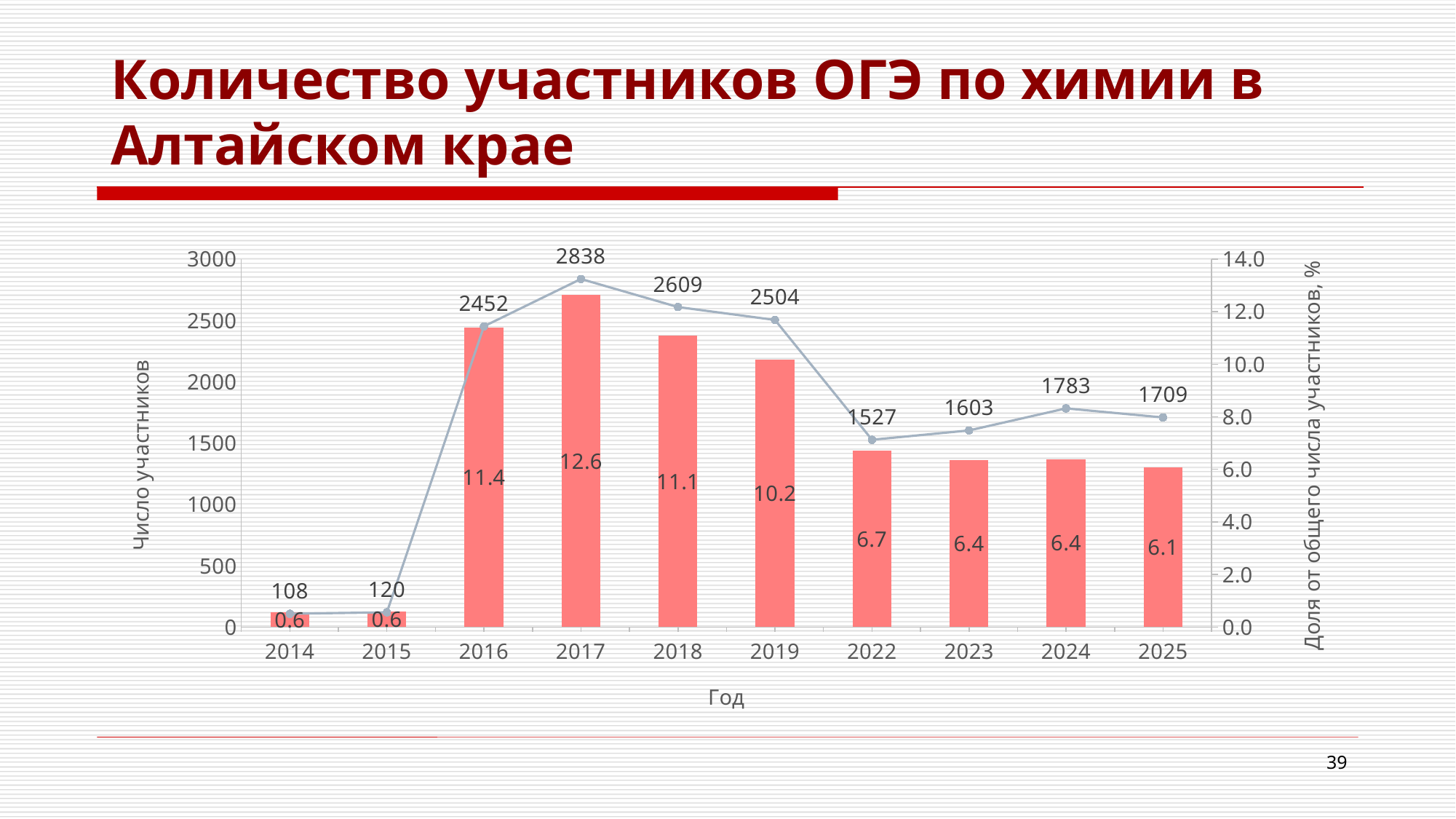
Which year has the larger number of participants, 2018 or 2019? 2018 Is the share value (bar) for 2016 greater or less than 10.0? greater What share of the total number of participants (bar label) is shown for 2019? 10.2 Which year has the lowest number of participants on the line? 2014 How many years are shown on the x axis? 10 Which year has the highest number of participants on the line? 2017 Does the number of participants rise or fall from 2019 to 2022? fall What is the number of participants shown for 2022? 1527 What is the difference in the share (bar label) between 2017 and 2016? 1.2 What is the title of the chart slide? Количество участников ОГЭ по химии в Алтайском крае What is the difference in the number of participants between 2017 and 2025? 1129 What is the number of participants (line value) for 2017? 2838